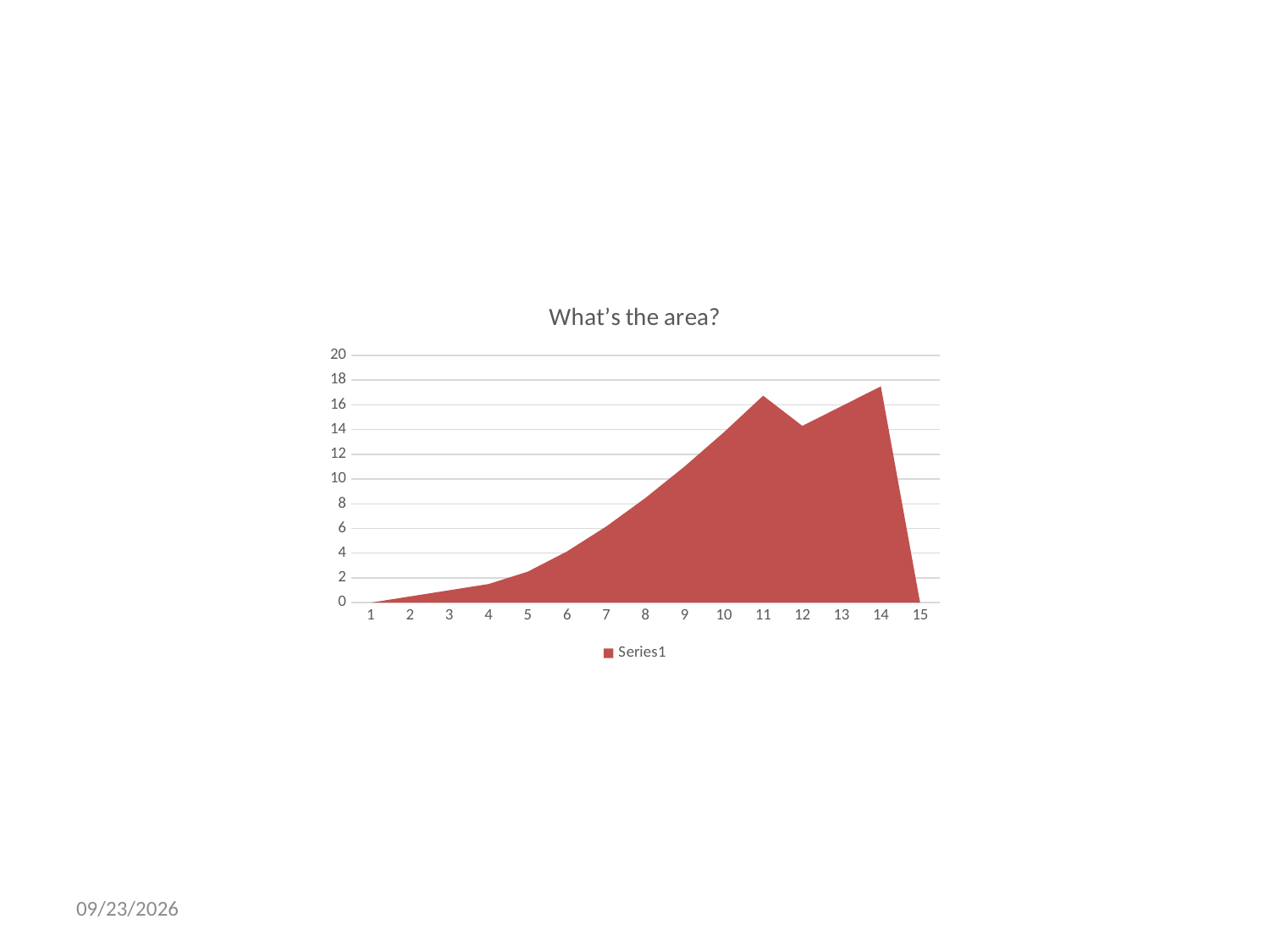
How many points are plotted along the x axis? 15 At which x-axis category does the series reach its highest value? 14 What kind of chart is shown on the slide? Area chart Is the value at x = 12 greater or less than 16? less Do the values rise or fall from x = 1 to x = 11? rise How many series does the legend list? 1 What is the name of the series shown in the legend? Series1 Is the value at x = 7 greater or less than 4? greater Is the value at x = 15 greater or less than 2? less What is the title of the chart? What's the area? Which has the larger value, x = 11 or x = 12? 11